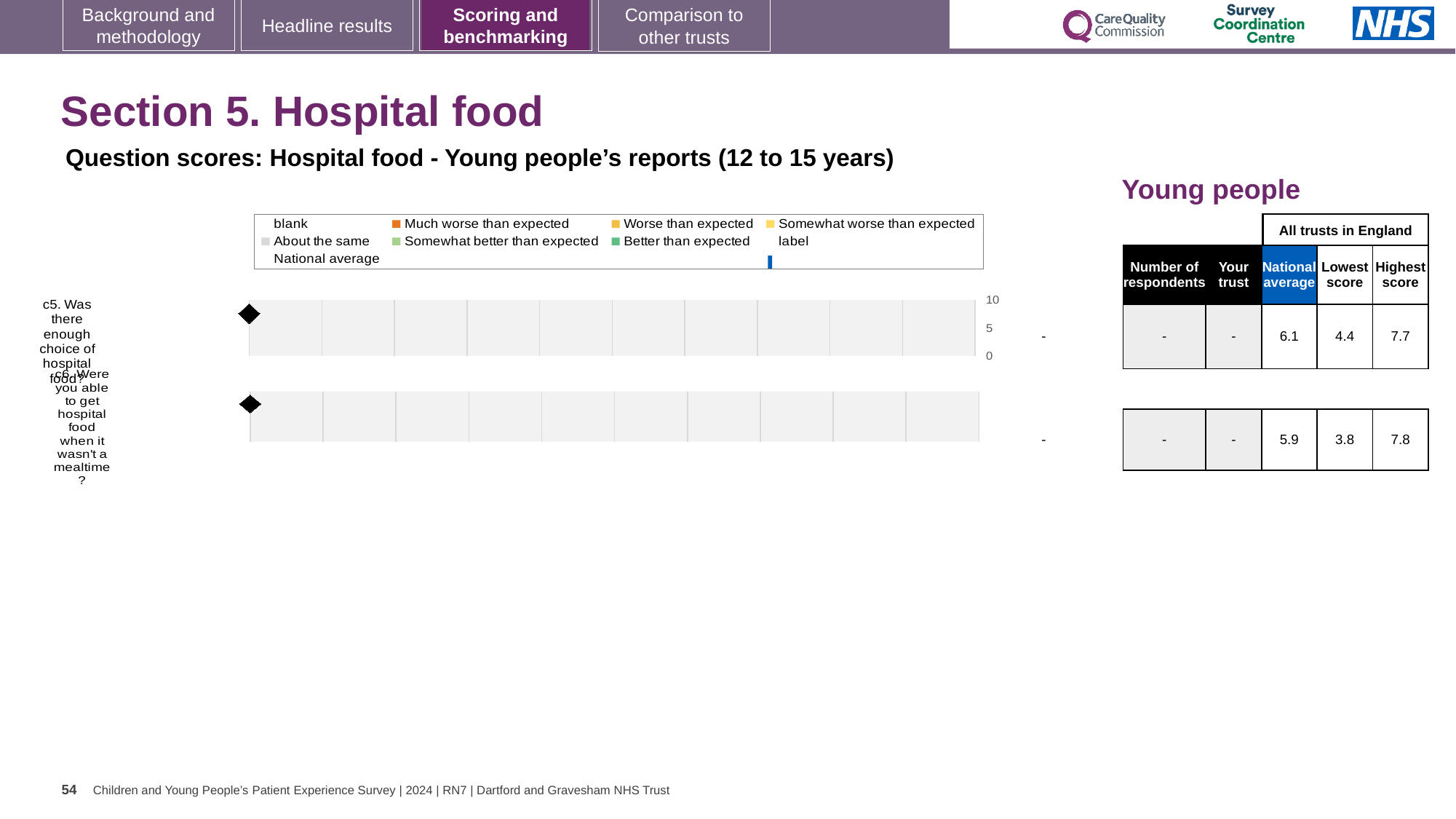
In the table next to the chart, what is the national average for c5 (enough choice of hospital food)? 6.1 What colour does the legend use for 'Much worse than expected'? orange In the table next to the chart, what is the lowest score for c5? 4.4 In the table next to the chart, which question has the higher national average, c5 or c6? c5 In the table next to the chart, what is the difference between the highest and lowest score for c6? 4.0 In the table next to the chart, what is the difference between the highest and lowest score for c5? 3.3 What is the highest value shown on the chart's numeric axis? 10 In the table next to the chart, what is the highest score for c6? 7.8 How many question categories are listed on the chart's vertical axis? 2 In the table next to the chart, what is the national average for c6 (able to get hospital food when it wasn't a mealtime)? 5.9 What kind of chart is shown on the slide? bar chart